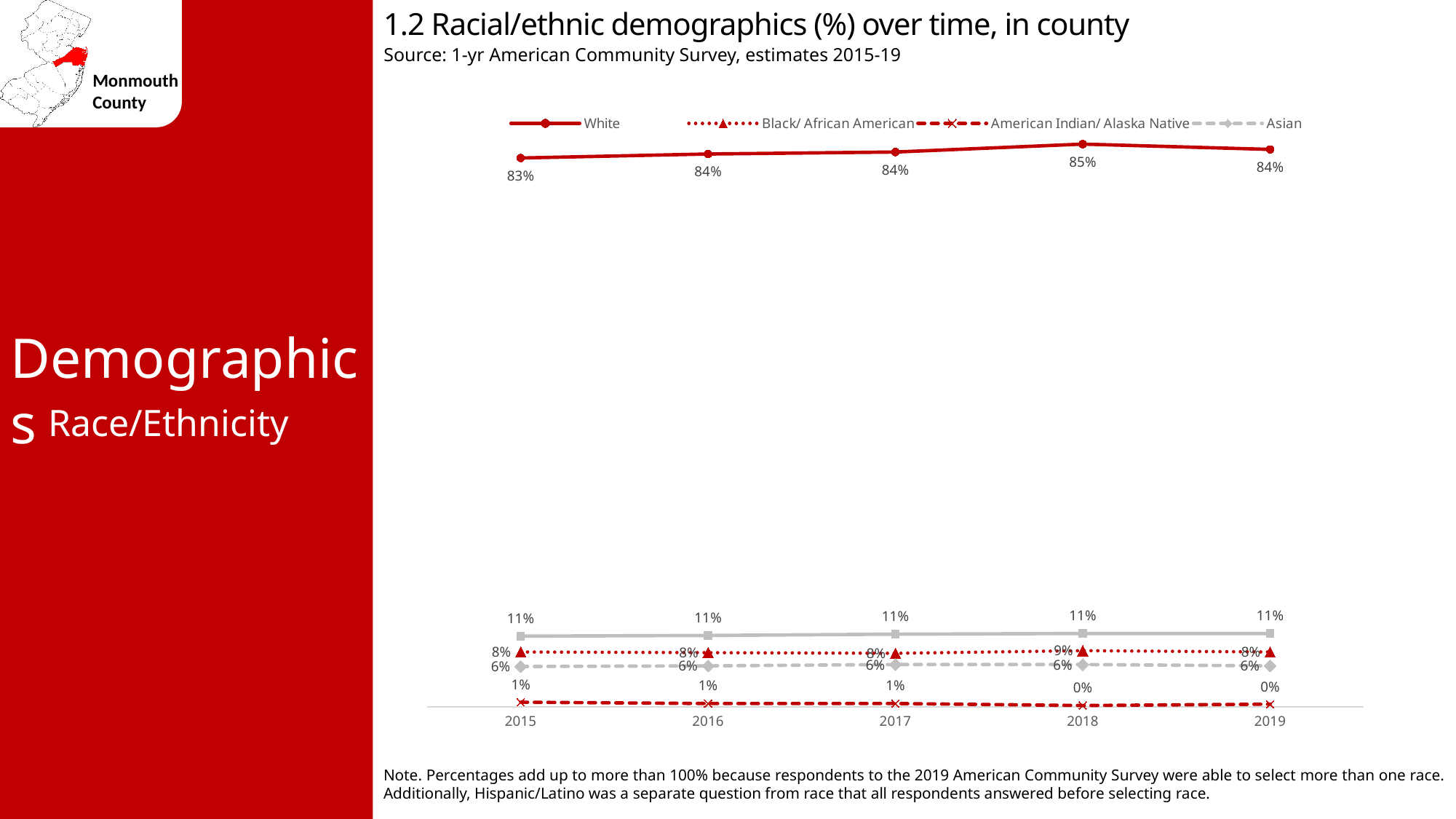
What is the value for White in 2018? 85% How many series are listed in the legend? 4 What is the difference between the White value in 2018 and in 2015? 2 percentage points What is the value for Black/ African American in 2018? 9% In which year is the White series at its highest? 2018 How many years are shown on the x axis? 5 What is the value for American Indian/ Alaska Native in 2019? 0% Does the White series rise or fall from 2015 to 2018? Rise What is the value for White in 2015? 83% What is the value for Asian in 2017? 6% In 2016, which is larger: Black/ African American or Asian? Black/ African American What kind of chart is this? Line chart